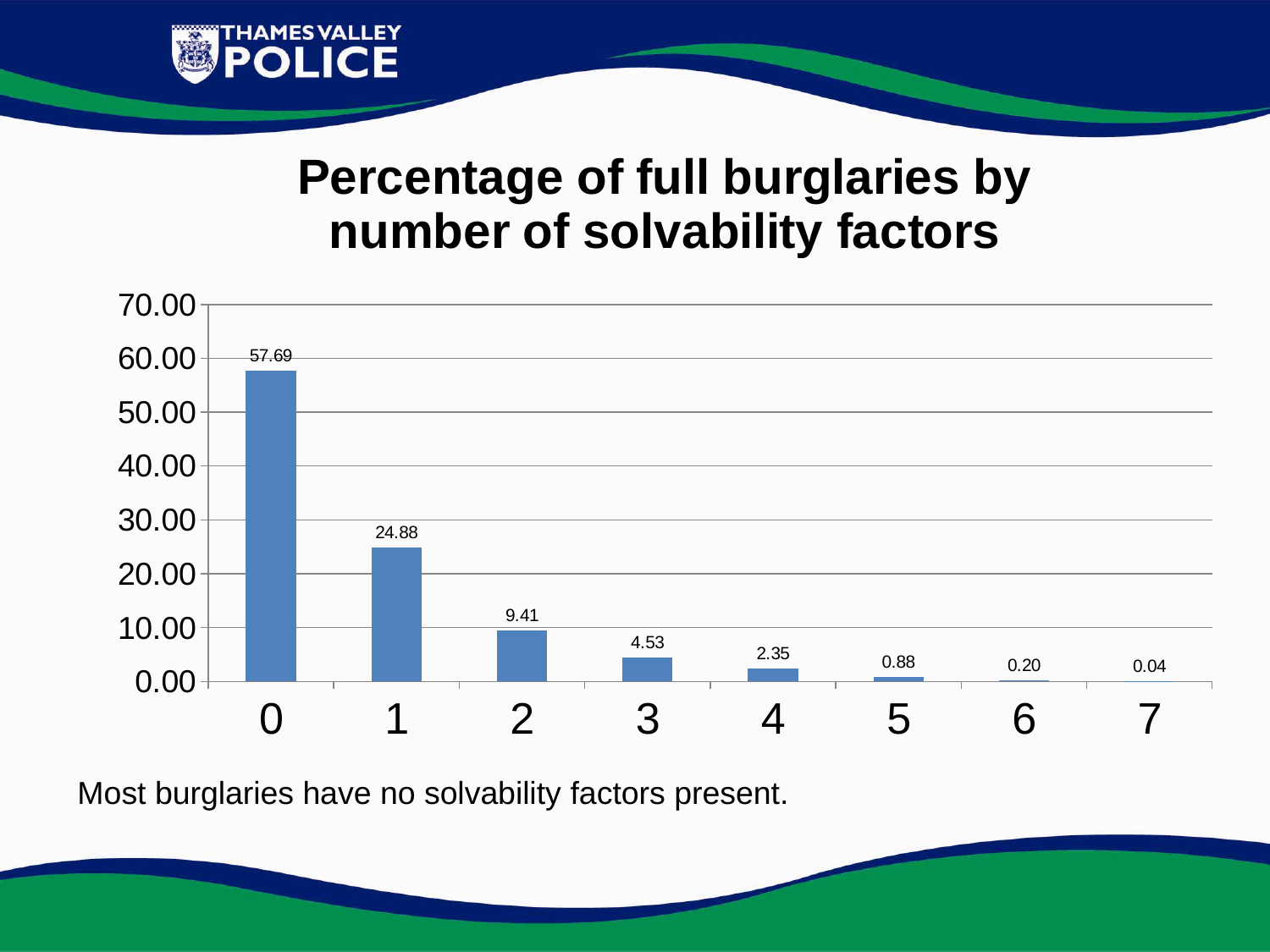
What kind of chart is shown on the slide? bar chart How many categories (numbers of solvability factors) are shown on the x axis? 8 Which number of solvability factors has the lowest percentage of full burglaries? 7 What is the difference between the percentage for 3 solvability factors and the percentage for 4 solvability factors? 2.18 Do the values rise or fall as the number of solvability factors increases along the x axis? fall What is the percentage of full burglaries with 2 solvability factors? 9.41 Which number of solvability factors has the highest percentage of full burglaries? 0 Is the value for 1 solvability factor greater or less than 20.00? greater What is the percentage of full burglaries with 0 solvability factors? 57.69 What is the difference between the percentage for 0 solvability factors and the percentage for 1 solvability factor? 32.81 What is the percentage of full burglaries with 5 solvability factors? 0.88 Which has a higher percentage: 1 solvability factor or 2 solvability factors? 1